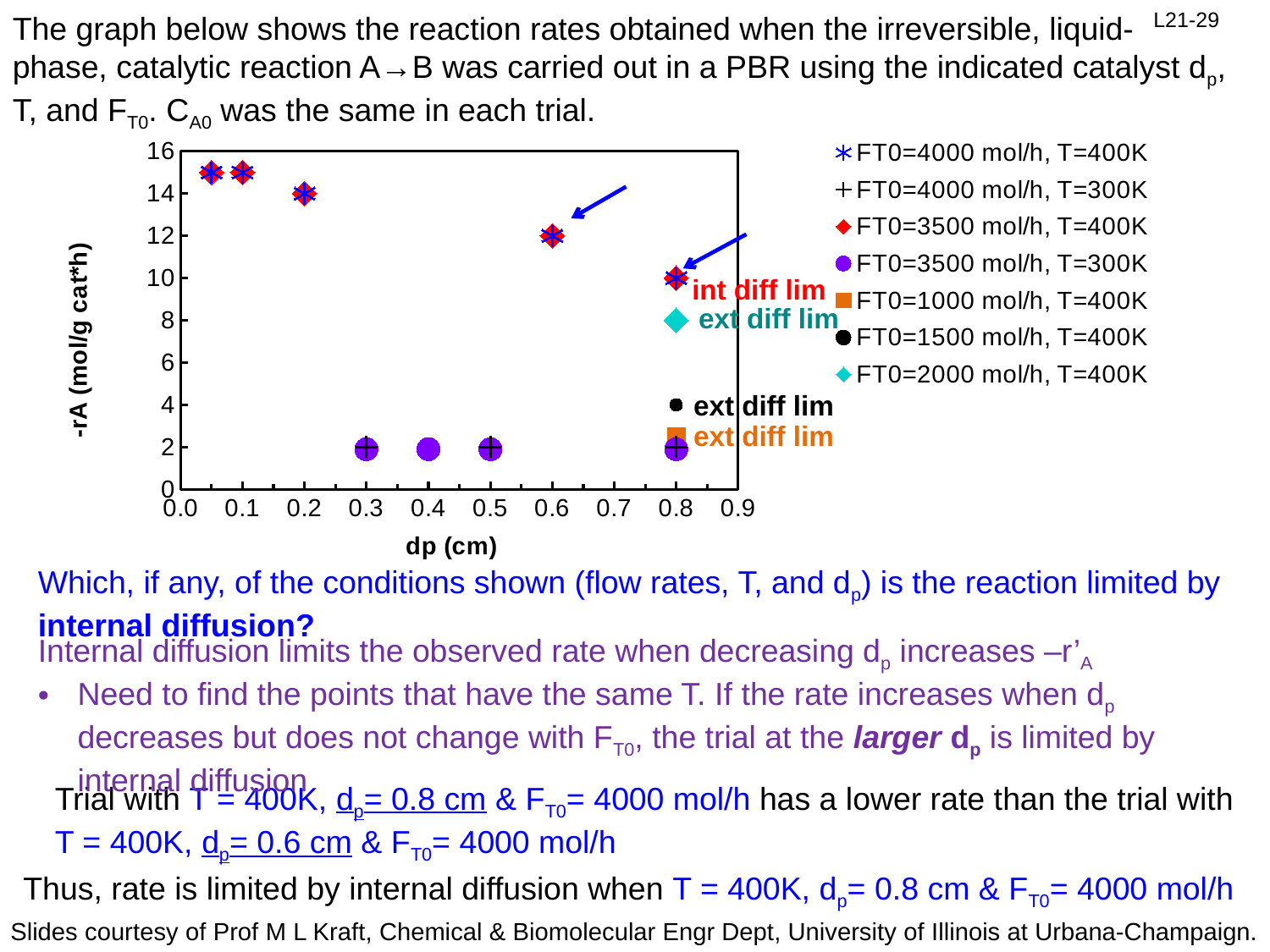
For FT0=4000 mol/h, T=400K, which dp gives the larger reaction rate: 0.6 cm or 0.8 cm? 0.6 cm For the T=400K series, does the reaction rate rise or fall as dp increases? fall Is the reaction rate at dp = 0.4 cm for FT0=3500 mol/h, T=300K greater or less than 4? less What is the reaction rate -rA for the FT0=1500 mol/h, T=400K point at dp = 0.8 cm? 4 How many series does the legend list? 7 For FT0=4000 mol/h, T=400K, what is the difference in reaction rate between dp = 0.6 cm and dp = 0.8 cm? 2 What is the reaction rate -rA at dp = 0.2 cm for FT0=4000 mol/h, T=400K? 14 What kind of chart is shown on the slide? scatter chart What is the reaction rate -rA for the FT0=2000 mol/h, T=400K point at dp = 0.8 cm? 8 Is the reaction rate at dp = 0.1 cm for T=400K greater or less than 14? greater What is the reaction rate -rA at dp = 0.6 cm for FT0=4000 mol/h, T=400K? 12 What is the reaction rate -rA at dp = 0.8 cm for FT0=4000 mol/h, T=400K? 10